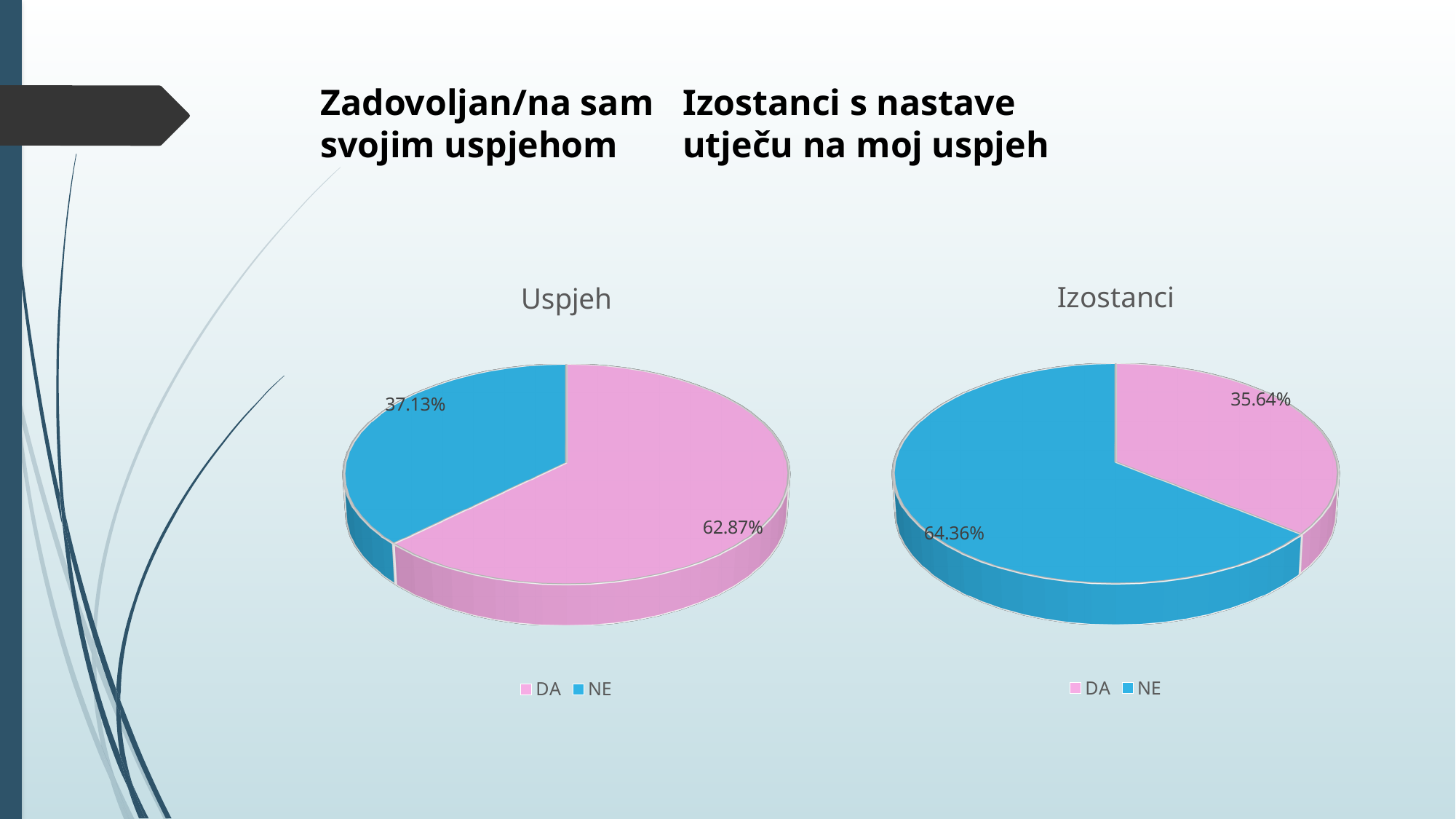
In the 'Uspjeh' pie chart, what is the difference in percentage points between DA and NE? 25.74 How many entries does the legend of the 'Izostanci' chart list? 2 In the 'Uspjeh' pie chart, what percentage is shown for NE? 37.13% How many slices does the 'Uspjeh' pie chart have? 2 In the 'Uspjeh' pie chart, what percentage is shown for DA? 62.87% In the 'Uspjeh' pie chart, what colour is the DA slice? Pink What type of chart is the 'Izostanci' chart? Pie chart In the 'Izostanci' pie chart, what percentage is shown for DA? 35.64% In the 'Izostanci' pie chart, which slice is the smallest? DA In the 'Uspjeh' pie chart, which slice is the largest? DA In the 'Izostanci' pie chart, what percentage is shown for NE? 64.36% In the 'Izostanci' pie chart, which is larger, DA or NE? NE